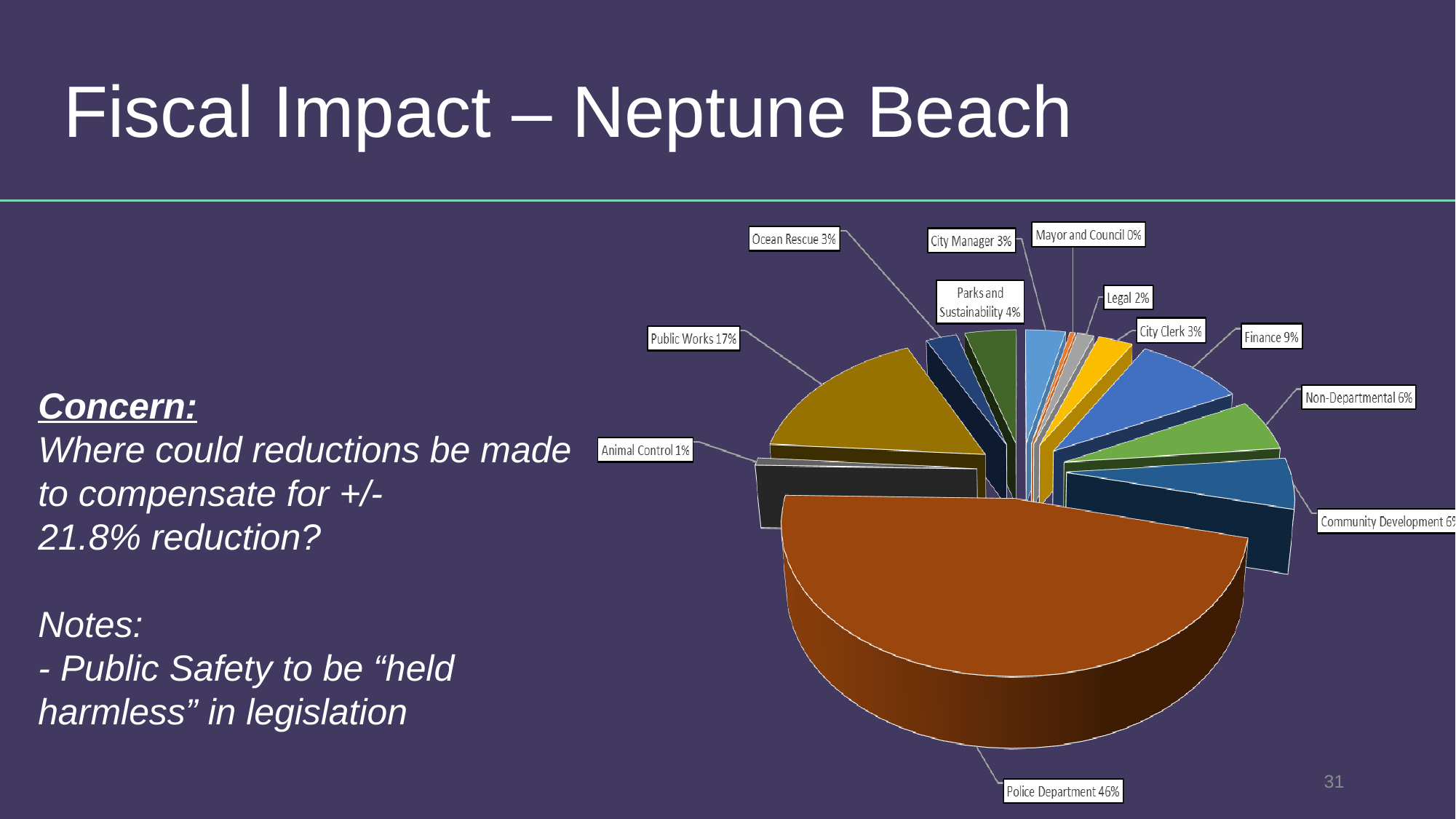
What percentage is shown for Finance? 9% Which category has the smallest share shown on the chart? Mayor and Council Which is larger, the share for Finance or the share for Non-Departmental? Finance What type of chart is shown on the slide? pie chart How many categories are labelled on the pie chart? 12 What percentage is shown for Mayor and Council? 0% What percentage is shown for Parks and Sustainability? 4% What share of the pie does the Police Department slice represent? 46% What is the difference in percentage points between Police Department and Public Works? 29 Which category has the largest slice of the pie? Police Department What is the combined share of Non-Departmental and Community Development? 12% What percentage is shown for Public Works? 17%